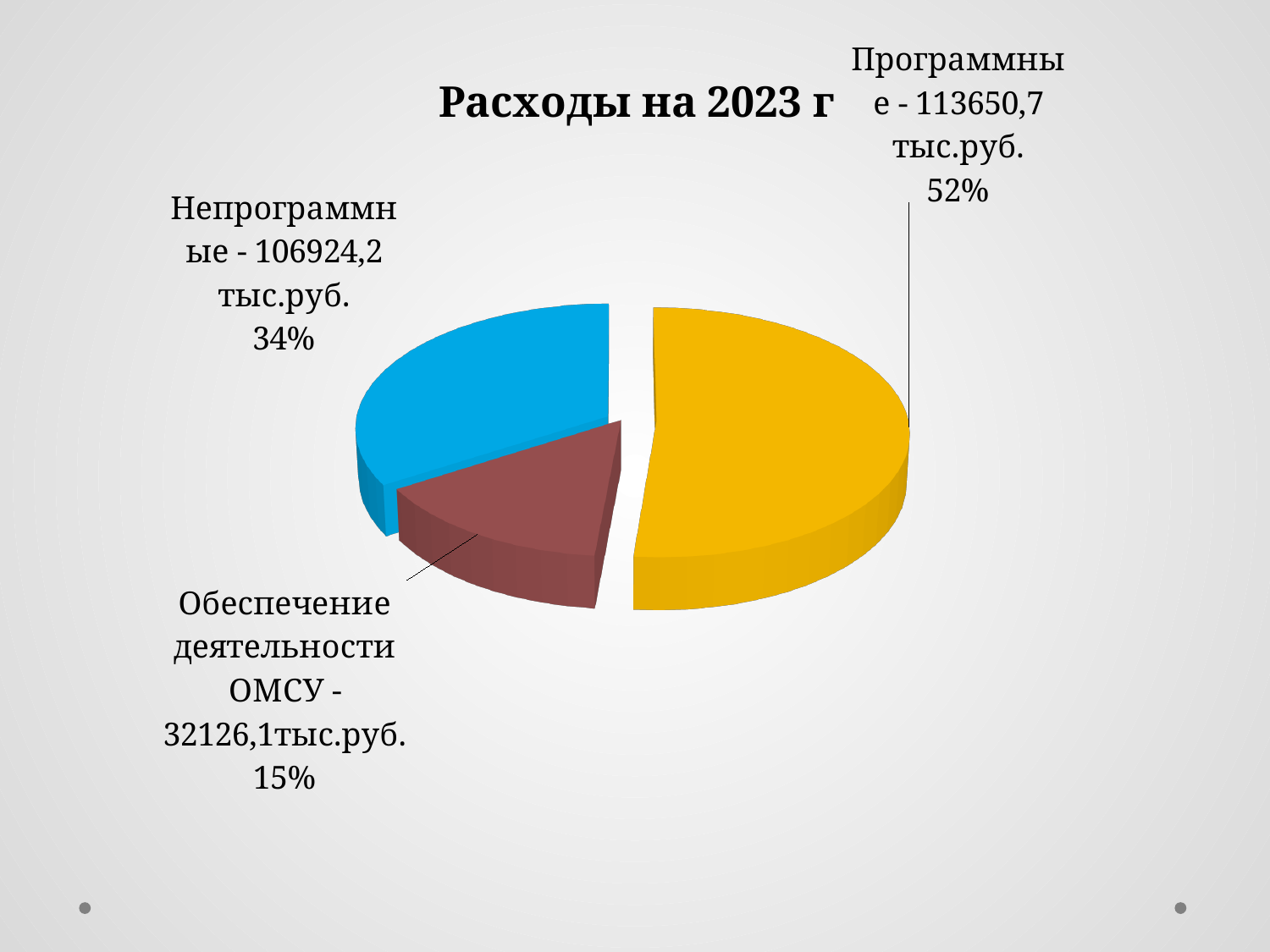
How many slices does the pie chart have? 3 What is the title of the chart? Расходы на 2023 г What is the value for Программные? 113650,7 тыс.руб. What kind of chart is shown on the slide? Pie chart What is the difference between the values for Программные and Непрограммные? 6726,5 тыс.руб. What share of the pie does Программные represent? 52% What is the value for Непрограммные? 106924,2 тыс.руб. What share of the pie does Обеспечение деятельности ОМСУ represent? 15% What share of the pie does Непрограммные represent? 34% Which category has the largest slice? Программные Which category has the smallest slice? Обеспечение деятельности ОМСУ What is the value for Обеспечение деятельности ОМСУ? 32126,1 тыс.руб.